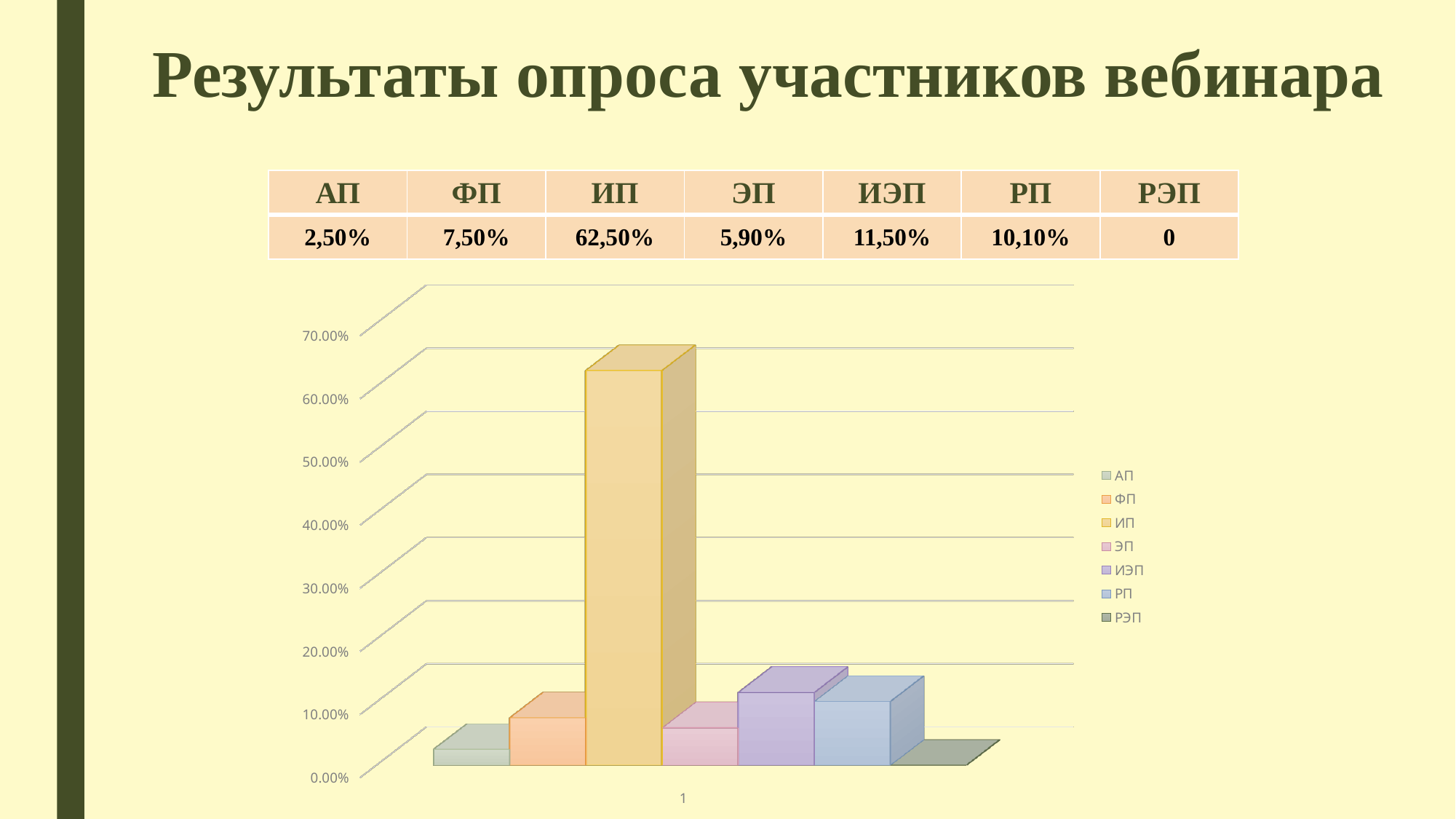
What kind of chart is shown on the slide? bar chart Which is larger, the value for ФП or the value for ЭП? ФП What is the value for АП? 2,50% What is the title of the slide? Результаты опроса участников вебинара What is the value for ИП? 62,50% Is the value for РП greater or less than 20.00%? less How many series does the legend list? 7 What is the value for ИЭП? 11,50% What is the difference between the values for ИЭП and РП? 1,40% Which category has the lowest value? РЭП Which category has the highest value? ИП Is the value for ИП greater or less than 60.00%? greater